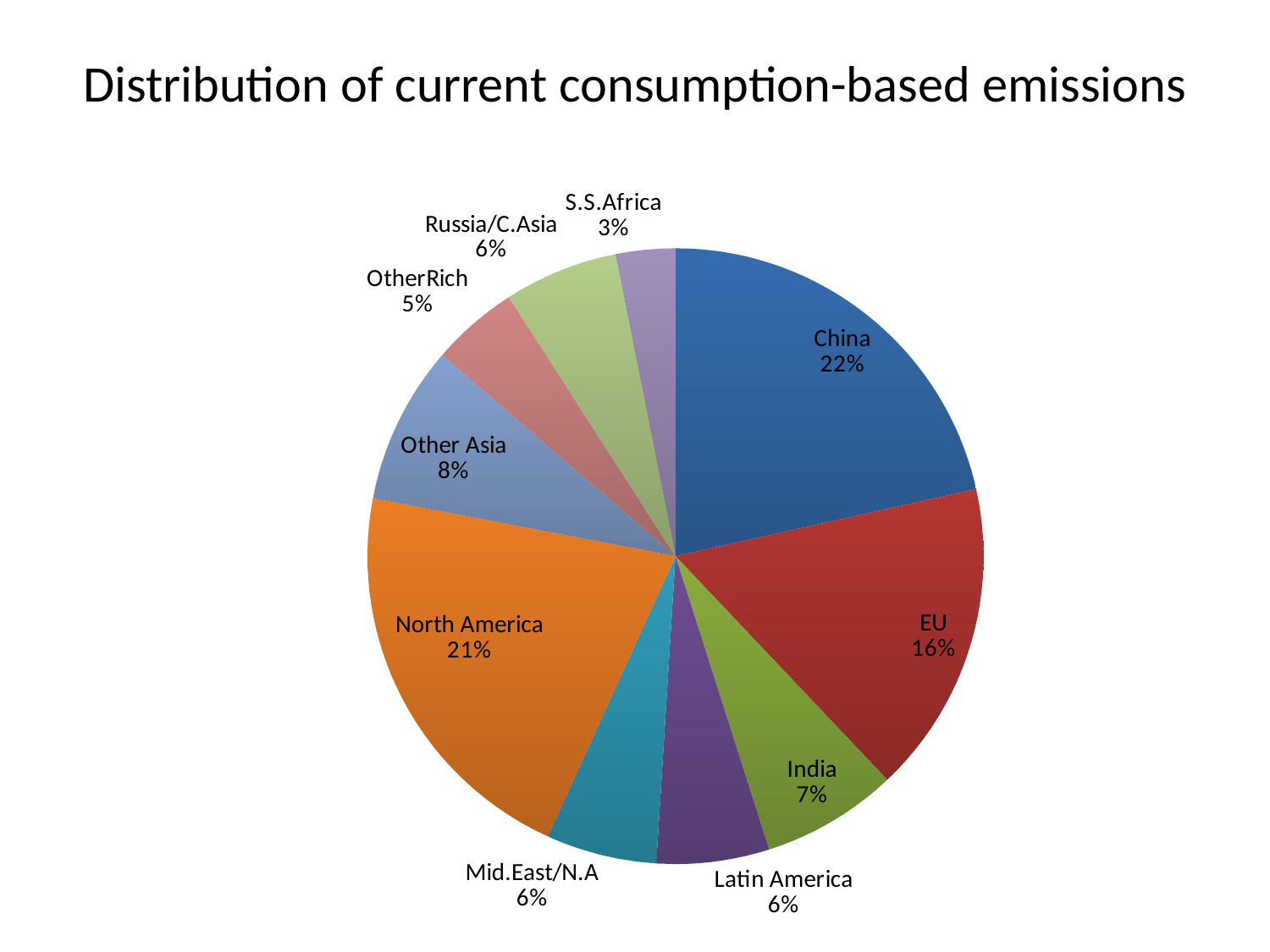
Which has a larger share of emissions, India or Other Asia? Other Asia What type of chart is shown on the slide? Pie chart How many regions are shown in the pie chart? 10 What is the share for Other Asia? 8% What percentage of emissions comes from the EU? 16% What is the difference in percentage points between China's share and the EU's share? 6 Which region has the largest share of consumption-based emissions? China Which region has the smallest share of consumption-based emissions? S.S.Africa What is the combined share of China and North America? 43% What is the title of the chart? Distribution of current consumption-based emissions What share of emissions is attributed to North America? 21% What share of current consumption-based emissions does China account for? 22%